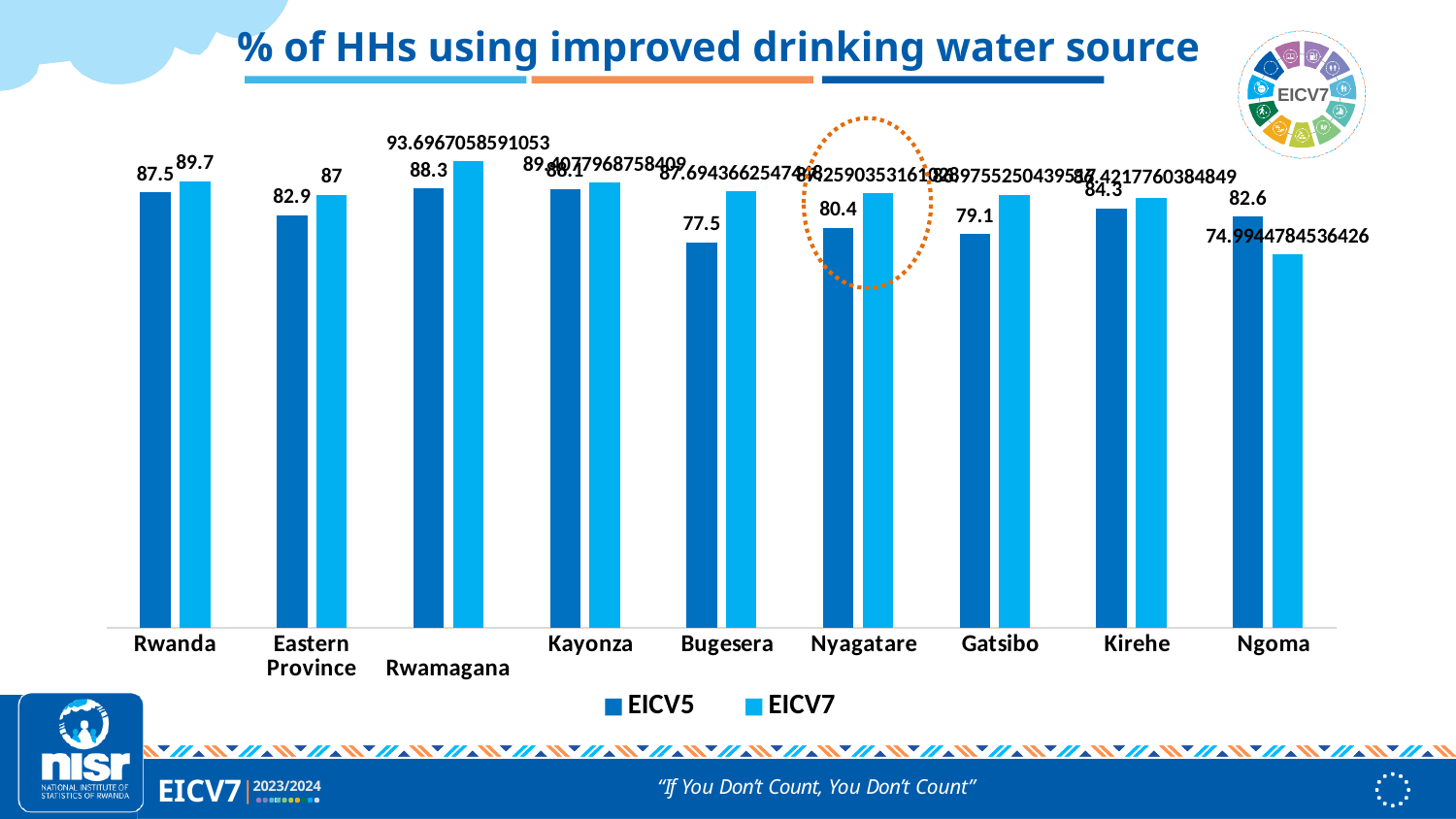
How many series does the legend list? 2 What is the EICV7 value for Ngoma? 74.9944784536426 What is the difference between the EICV7 and EICV5 values for Rwanda? 2.2 What is the difference between the EICV7 and EICV5 values for Eastern Province? 4.1 What kind of chart is shown on the slide? Bar chart What is the EICV7 value for Rwanda? 89.7 What is the EICV5 value for Bugesera? 77.5 Which category has the lowest EICV5 value? Bugesera Which district has the highest EICV7 value? Rwamagana How many categories are shown on the x axis? 9 What is the EICV5 value for Eastern Province? 82.9 For Ngoma, which is larger: the EICV5 value or the EICV7 value? EICV5